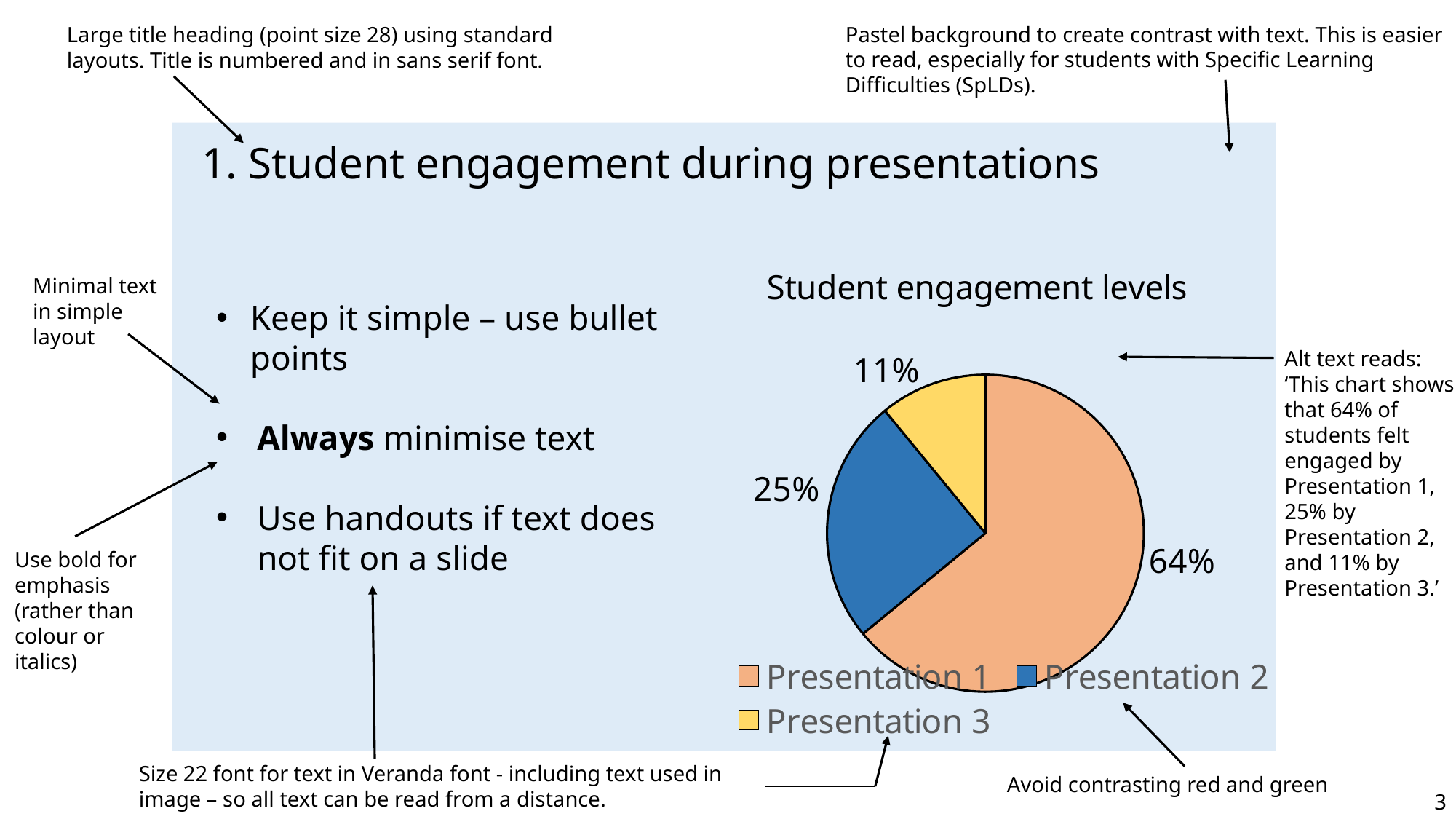
What is the difference in percentage points between Presentation 2 and Presentation 3? 14 Which presentation has the largest share of the pie? Presentation 1 What percentage of the pie is Presentation 1? 64% What is the title of the chart? Student engagement levels What type of chart is shown on the slide? pie chart What colour is the slice for Presentation 2? blue Which is larger, the share for Presentation 2 or Presentation 3? Presentation 2 What percentage of the pie is Presentation 3? 11% What is the difference in percentage points between Presentation 1 and Presentation 2? 39 What percentage of the pie is Presentation 2? 25% How many slices does the pie chart have? 3 Which presentation has the smallest share of the pie? Presentation 3